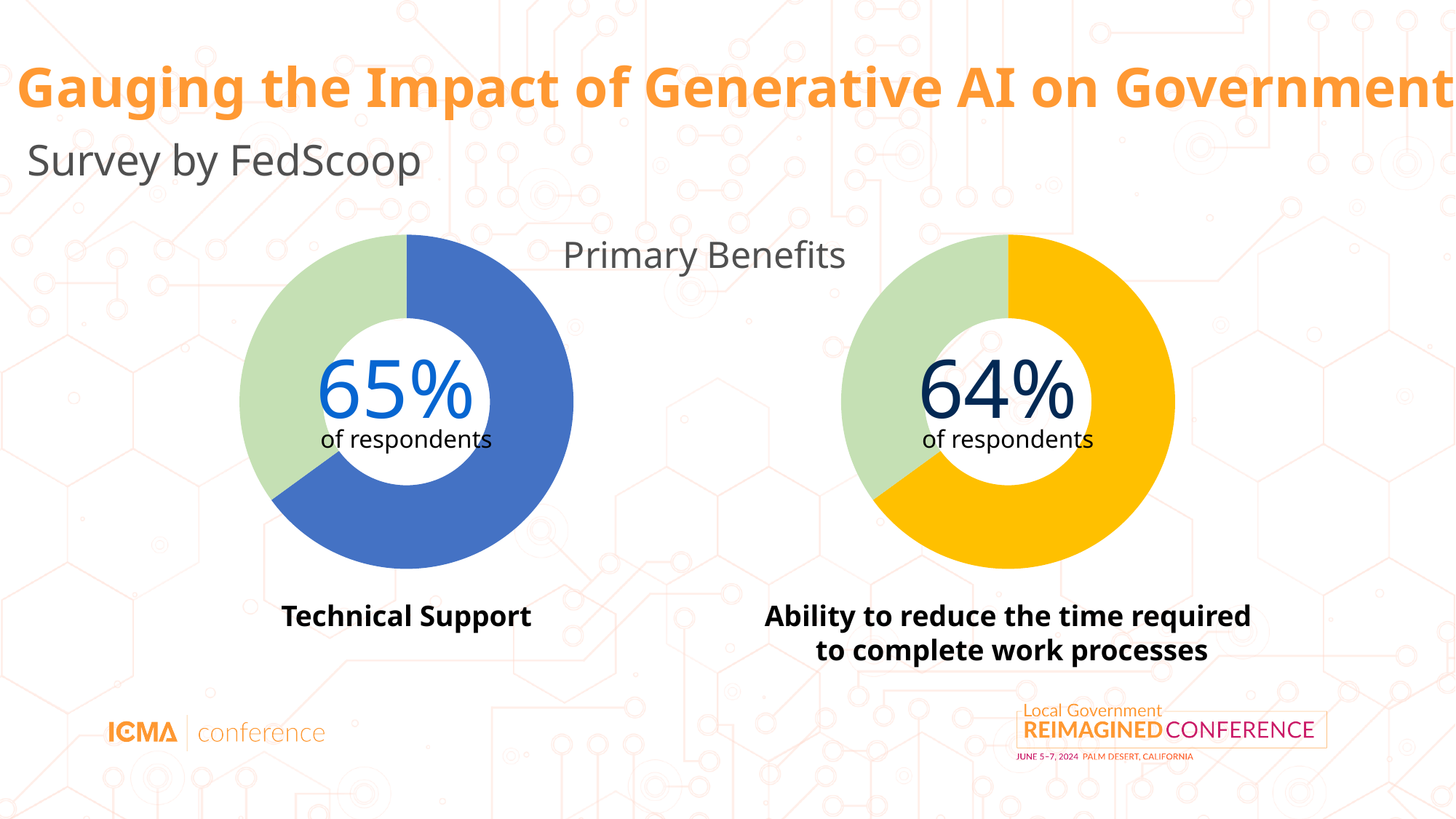
On the right donut chart, what percentage of respondents cited the ability to reduce the time required to complete work processes? 64% What colour is the slice representing the 64% of respondents on the right donut chart? Yellow How many donut charts are shown on the slide? 2 What is the difference in percentage points between the Technical Support share (65%) and the time-reduction share (64%)? 1 percentage point On the left donut chart, what share of the ring is taken up by the blue slice? 65% What kind of chart is used to show the Technical Support result on the left? Donut (pie) chart On the right donut chart, what share of the ring is taken up by the yellow slice? 64% On the left donut chart, what percentage of respondents cited Technical Support as a primary benefit? 65% On the left donut chart, what share of the ring does the green slice represent? 35% What is the heading shown between the two donut charts? Primary Benefits Which benefit has the higher share of respondents: Technical Support or the ability to reduce the time required to complete work processes? Technical Support